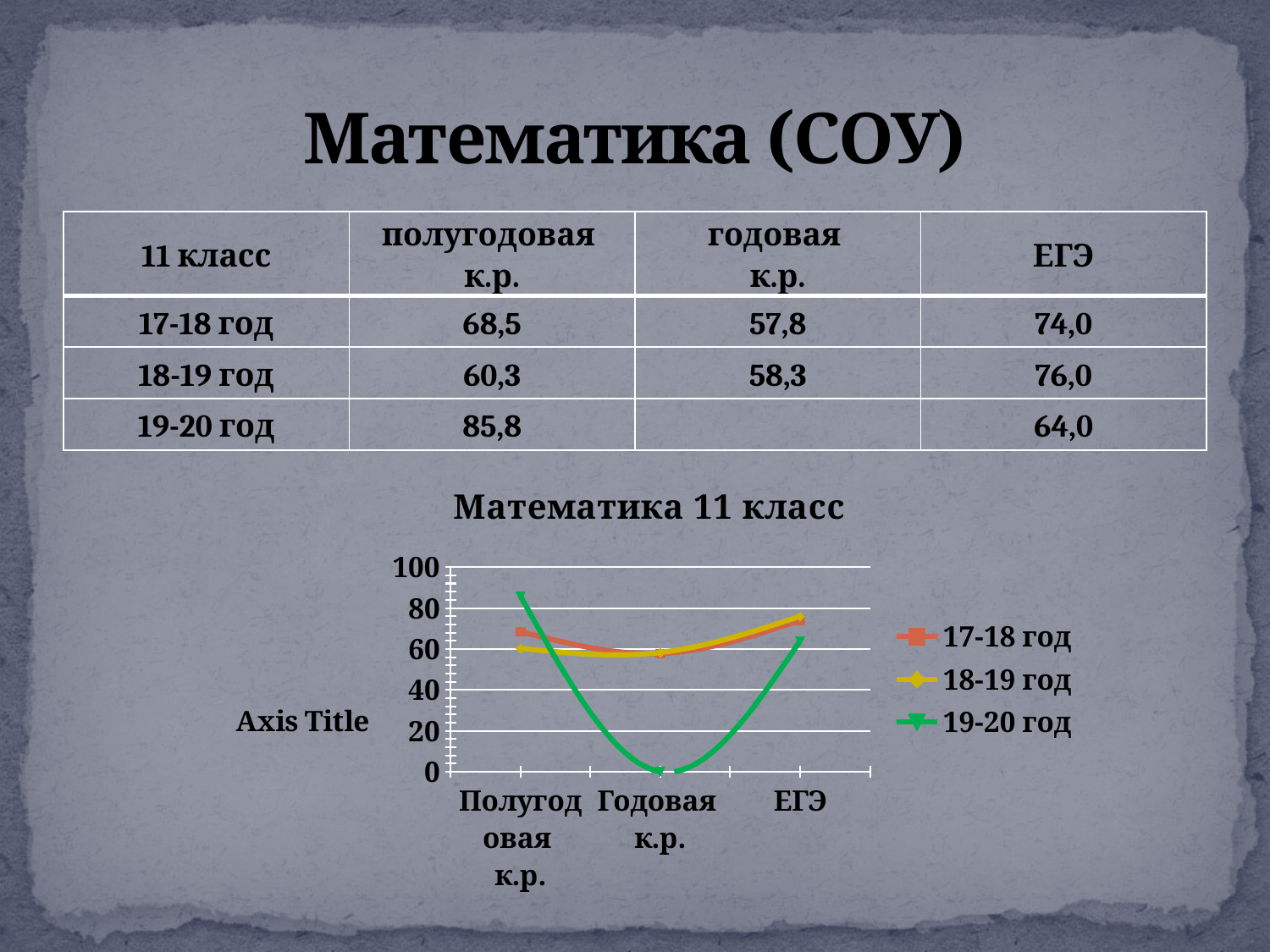
Is the value for 18-19 год at ЕГЭ greater or less than 70? greater Does the 18-19 год series rise or fall from Годовая к.р. to ЕГЭ? rises Which series has the highest value at Полугодовая к.р.? 19-20 год Which series is shown in green in the chart? 19-20 год How many series does the legend of the chart list? 3 How many categories are shown along the x axis of the chart? 3 What is the title of the chart? Математика 11 класс At Полугодовая к.р., which series has the larger value: 17-18 год or 18-19 год? 17-18 год What is the value for 17-18 год at ЕГЭ, as printed in the table on the slide? 74,0 What kind of chart is shown on the slide? line chart Is the value for 19-20 год at Полугодовая к.р. greater or less than 80? greater Which series has the lowest value at ЕГЭ? 19-20 год